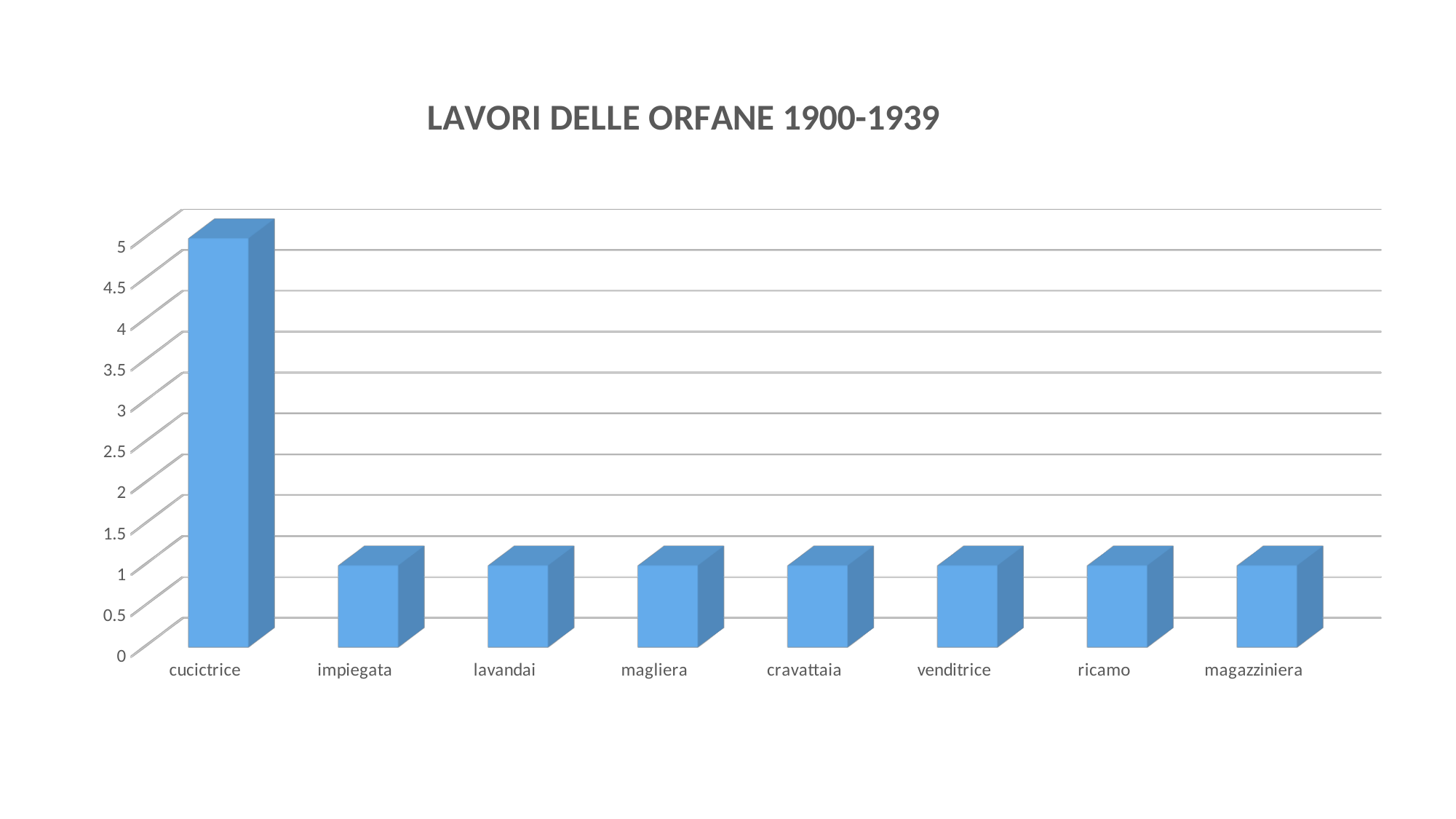
What is the highest value shown on the vertical axis? 5 What is the value for impiegata? 1 Is the value for cucictrice greater or less than 3? greater What is the value for magazziniera? 1 Is the value for lavandai greater or less than 2? less What is the title of the chart? LAVORI DELLE ORFANE 1900-1939 Which is larger, the value for cucictrice or the value for venditrice? cucictrice How many categories are shown on the x axis? 8 Which category has the highest value? cucictrice What is the difference between the values for cucictrice and ricamo? 4 What kind of chart is shown on the slide? bar chart What is the value for cucictrice? 5